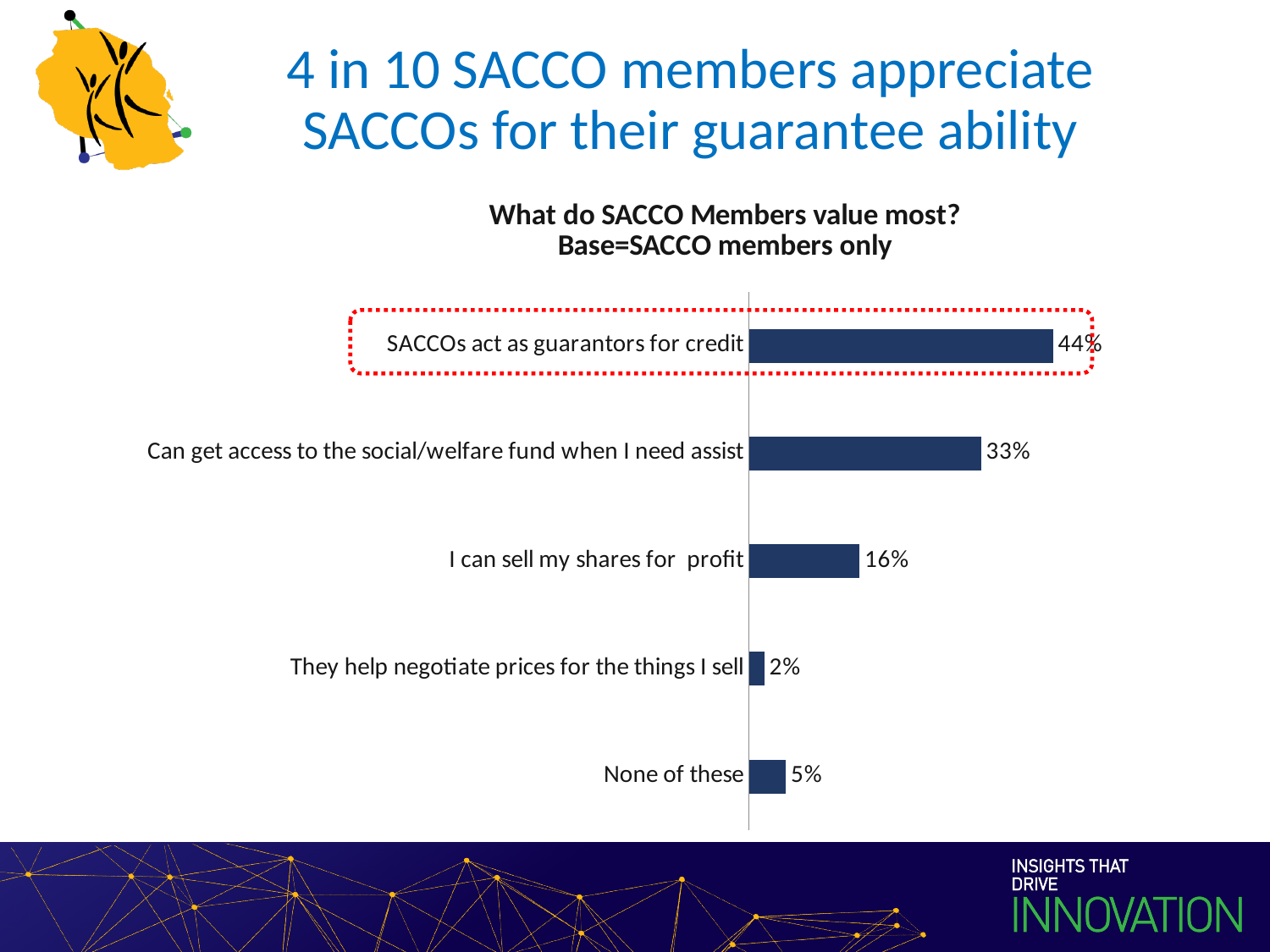
What kind of chart is shown on the slide? Bar chart What percentage of SACCO members value that SACCOs act as guarantors for credit? 44% Which is larger: 'None of these' or 'They help negotiate prices for the things I sell'? None of these What is the value for 'I can sell my shares for profit'? 16% What is the value for 'Can get access to the social/welfare fund when I need assist'? 33% How many categories are shown in the chart? 5 What is the difference between 'SACCOs act as guarantors for credit' and 'Can get access to the social/welfare fund when I need assist'? 11% Which category has the highest value? SACCOs act as guarantors for credit What is the value for 'None of these'? 5% What is the title of the chart? What do SACCO Members value most? Base=SACCO members only What is the value for 'They help negotiate prices for the things I sell'? 2% Which category has the lowest value? They help negotiate prices for the things I sell